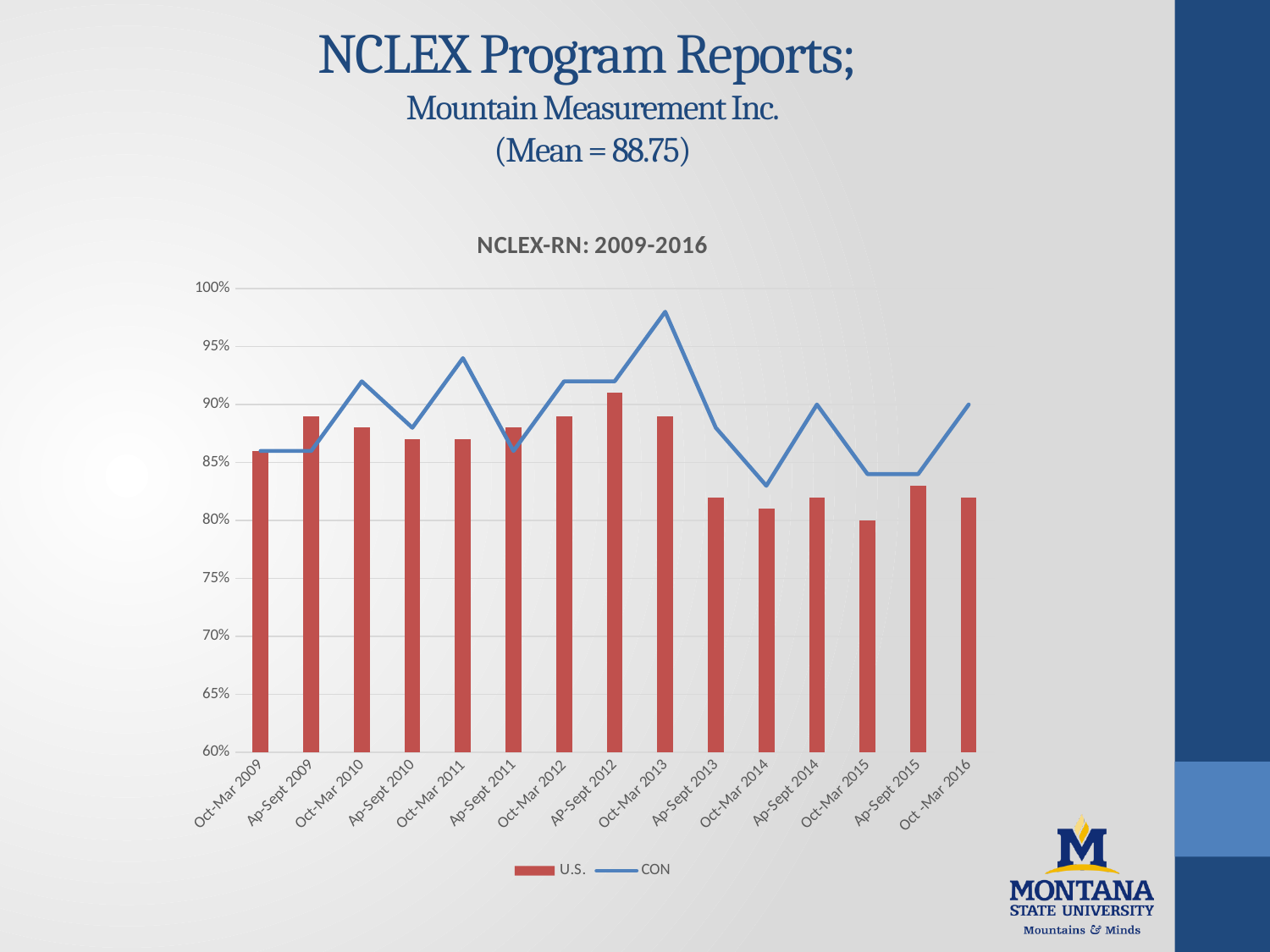
Is the U.S. value for Oct-Mar 2014 greater or less than 85%? less What kind of chart is shown on the slide? A combined bar and line chart Is the CON value for Oct-Mar 2013 greater or less than 95%? greater Which is larger in Oct-Mar 2011, the U.S. value or the CON value? CON In which period does the CON line reach its highest point? Oct-Mar 2013 Which period has the highest U.S. bar? Ap-Sept 2012 How many series does the legend list? 2 How many time periods are shown along the x axis? 15 Is the CON value for Oct-Mar 2014 greater or less than 85%? less Do the U.S. bars generally rise or fall from Oct-Mar 2013 onward compared with the earlier periods? fall What is the title of the chart? NCLEX-RN: 2009-2016